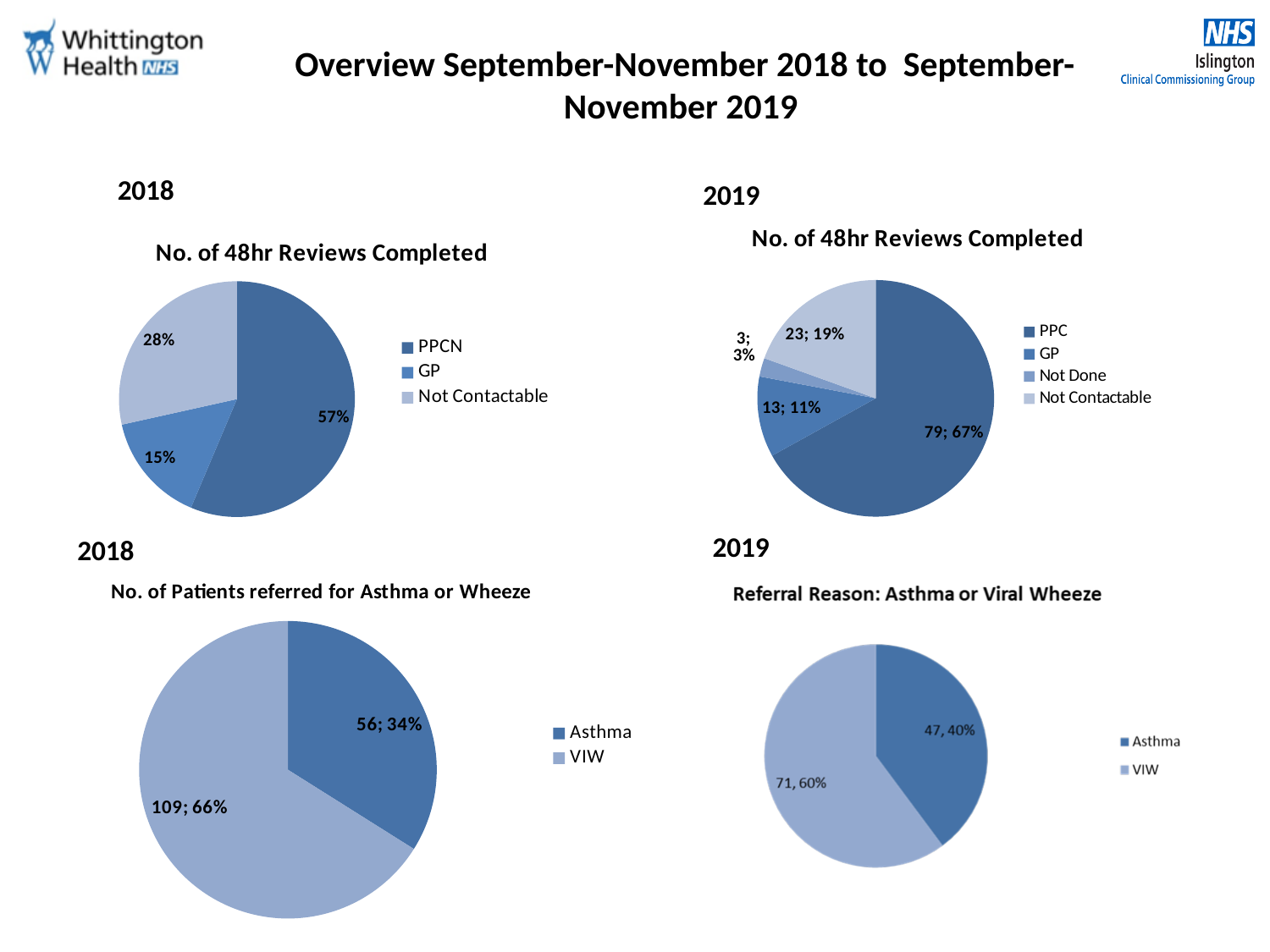
In the 2019 'No. of 48hr Reviews Completed' pie chart, how many reviews were completed by PPC? 79 In the 2019 'No. of 48hr Reviews Completed' pie chart, what is the difference between the GP count and the Not Done count? 10 What type of chart is the 2019 'Referral Reason: Asthma or Viral Wheeze' chart? Pie chart In the 2019 'Referral Reason: Asthma or Viral Wheeze' pie chart, which is larger, Asthma or VIW? VIW In the 2018 'No. of Patients referred for Asthma or Wheeze' pie chart, how many patients were referred for VIW? 109 In the 2018 'No. of 48hr Reviews Completed' pie chart, what share of reviews is PPCN? 57% In the 2019 'No. of 48hr Reviews Completed' pie chart, how many categories does the legend list? 4 In the 2019 'No. of 48hr Reviews Completed' pie chart, what share of the pie is Not Contactable? 19% In the 2018 'No. of 48hr Reviews Completed' pie chart, what percentage is Not Contactable? 28% In the 2018 'No. of Patients referred for Asthma or Wheeze' pie chart, what is the total number of patients across both slices? 165 In the 2019 'No. of 48hr Reviews Completed' pie chart, which category has the smallest count? Not Done In the 2018 'No. of 48hr Reviews Completed' pie chart, which category has the smallest slice? GP